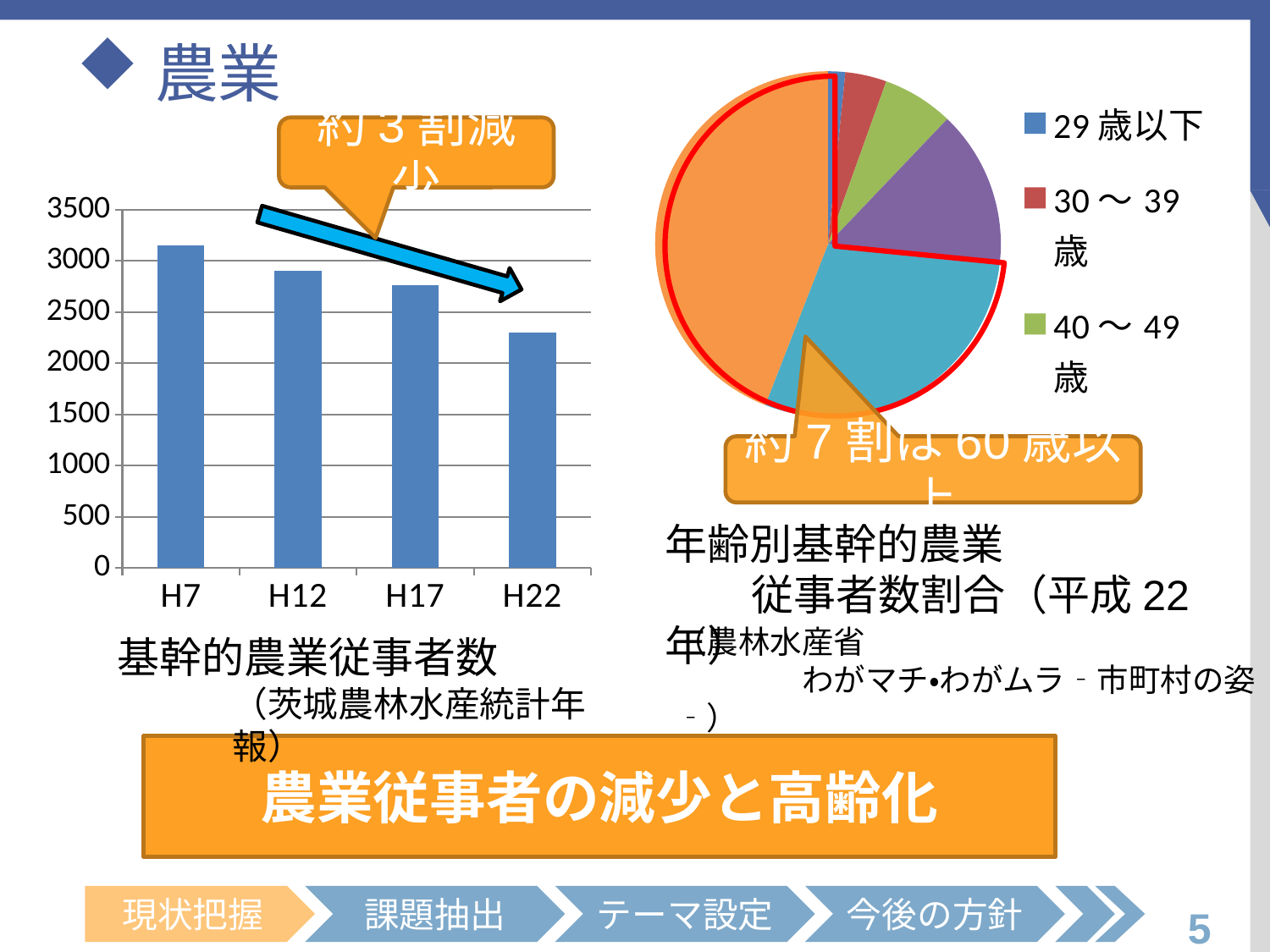
In the left bar chart (基幹的農業従事者数), which is larger, the value for H12 or the value for H17? H12 In the left bar chart (基幹的農業従事者数), is the value for H22 greater or less than 2500? less What kind of chart is the right chart (年齢別基幹的農業従事者数割合)? pie chart What kind of chart is the left chart (基幹的農業従事者数)? bar chart In the right pie chart (年齢別基幹的農業従事者数割合), which age group has the smallest slice? 29歳以下 In the left bar chart (基幹的農業従事者数), which category has the highest value? H7 In the left bar chart (基幹的農業従事者数), is the value for H7 greater or less than 3000? greater In the left bar chart (基幹的農業従事者数), which category has the lowest value? H22 In the left bar chart (基幹的農業従事者数), how many categories are shown on the x axis? 4 In the right pie chart (年齢別基幹的農業従事者数割合), what is the first entry listed in the legend? 29歳以下 In the left bar chart (基幹的農業従事者数), do the values rise or fall from H7 to H22? fall In the right pie chart (年齢別基幹的農業従事者数割合), which slice is larger, 30～39歳 or 40～49歳? 40～49歳